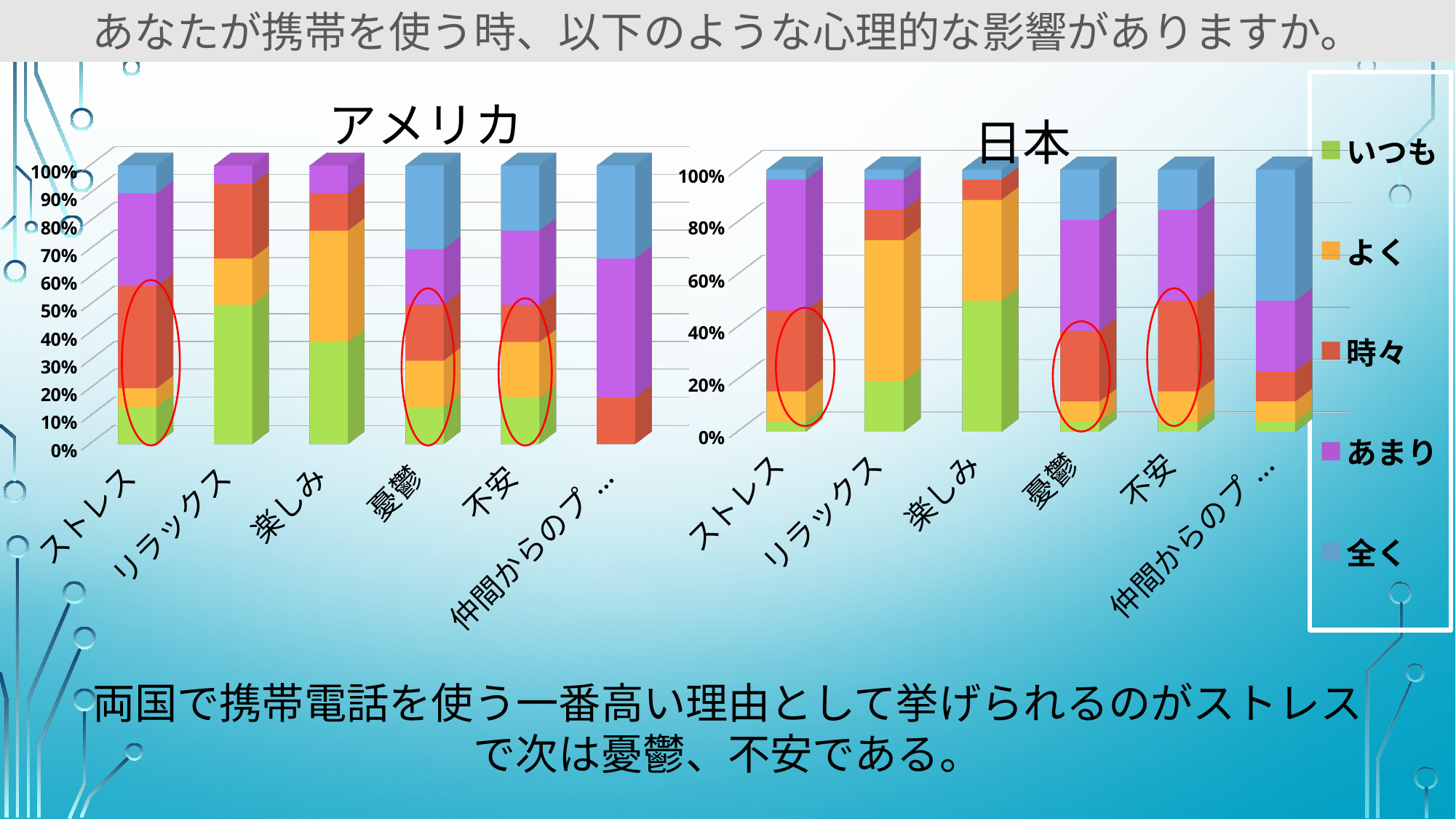
How many series does the legend list? 5 In the 日本 chart, which category has the largest いつも segment? 楽しみ Which legend entry is shown in green? いつも How many categories are shown on the x axis of the アメリカ chart? 6 What is the title of the left chart? アメリカ What kind of chart is the アメリカ chart? stacked bar chart How many categories are shown on the x axis of the 日本 chart? 6 In the アメリカ chart, is the いつも segment for リラックス greater or less than 30%? greater In the 日本 chart, is the いつも segment larger for 楽しみ or for ストレス? 楽しみ In the 日本 chart, is the いつも segment for 楽しみ greater or less than 20%? greater In the 日本 chart, is the いつも segment for ストレス greater or less than 20%? less In the アメリカ chart, is the いつも segment larger for リラックス or for ストレス? リラックス